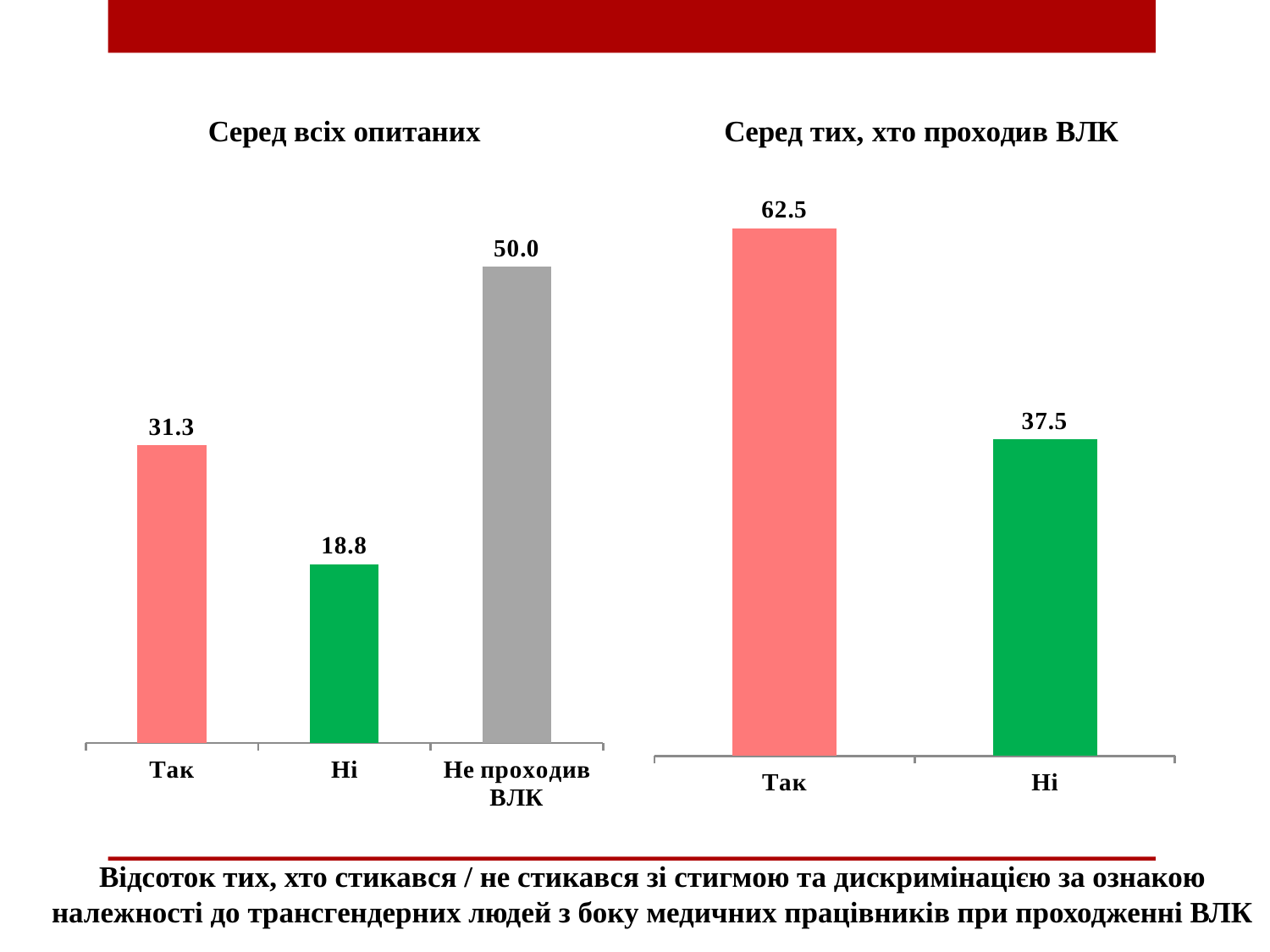
In the chart titled "Серед всіх опитаних", which category has the highest value? Не проходив ВЛК In the chart titled "Серед тих, хто проходив ВЛК", what is the value for "Ні"? 37.5 In the chart titled "Серед всіх опитаних", which category has the lowest value? Ні What type of chart is the chart titled "Серед тих, хто проходив ВЛК"? Bar chart In the chart titled "Серед всіх опитаних", what is the value for "Ні"? 18.8 How many categories are shown in the chart titled "Серед всіх опитаних"? 3 In the chart titled "Серед всіх опитаних", what is the value for "Так"? 31.3 In the chart titled "Серед всіх опитаних", what is the value for "Не проходив ВЛК"? 50.0 In the chart titled "Серед всіх опитаних", what is the difference between the values for "Так" and "Ні"? 12.5 In the chart titled "Серед тих, хто проходив ВЛК", what is the value for "Так"? 62.5 In the chart titled "Серед тих, хто проходив ВЛК", which is larger, "Так" or "Ні"? Так In the chart titled "Серед тих, хто проходив ВЛК", what is the difference between the values for "Так" and "Ні"? 25.0